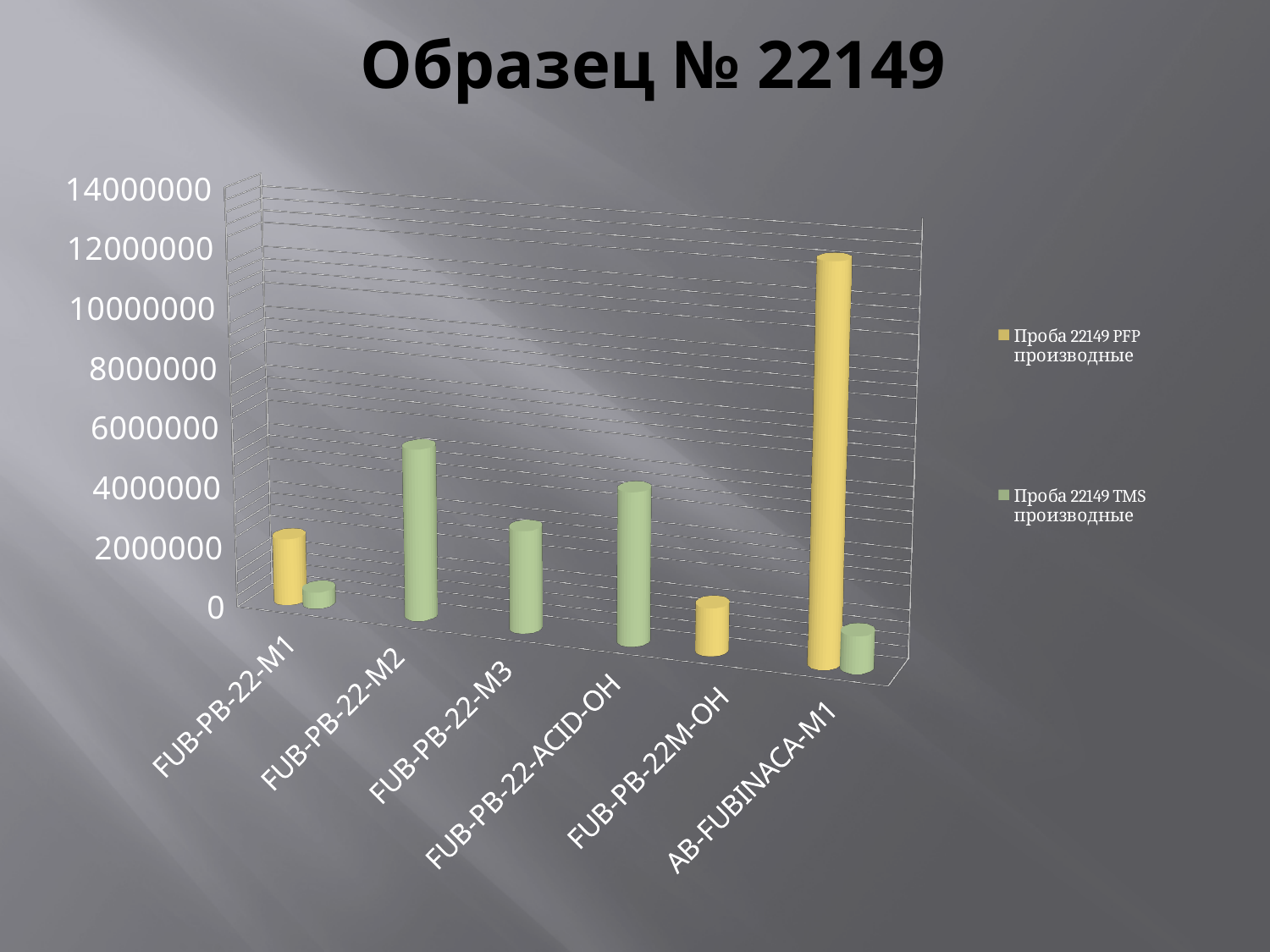
What is the title of the chart on the slide? Образец № 22149 Is the value of 'Проба 22149 PFP производные' for FUB-PB-22-M1 greater or less than 4000000? less For the series 'Проба 22149 TMS производные', which is larger: FUB-PB-22-M2 or FUB-PB-22-M3? FUB-PB-22-M2 How many series does the legend list? 2 Which colour represents the series 'Проба 22149 TMS производные'? green What kind of chart is shown on the slide? bar chart Is the value of 'Проба 22149 PFP производные' for AB-FUBINACA-M1 greater or less than 10000000? greater Is the value of 'Проба 22149 TMS производные' for FUB-PB-22-M2 greater or less than 4000000? greater Which category has the highest value for the series 'Проба 22149 PFP производные'? AB-FUBINACA-M1 How many categories are shown on the x axis? 6 For FUB-PB-22-M1, which series has the larger value: 'Проба 22149 PFP производные' or 'Проба 22149 TMS производные'? Проба 22149 PFP производные Which category has the highest value for the series 'Проба 22149 TMS производные'? FUB-PB-22-M2